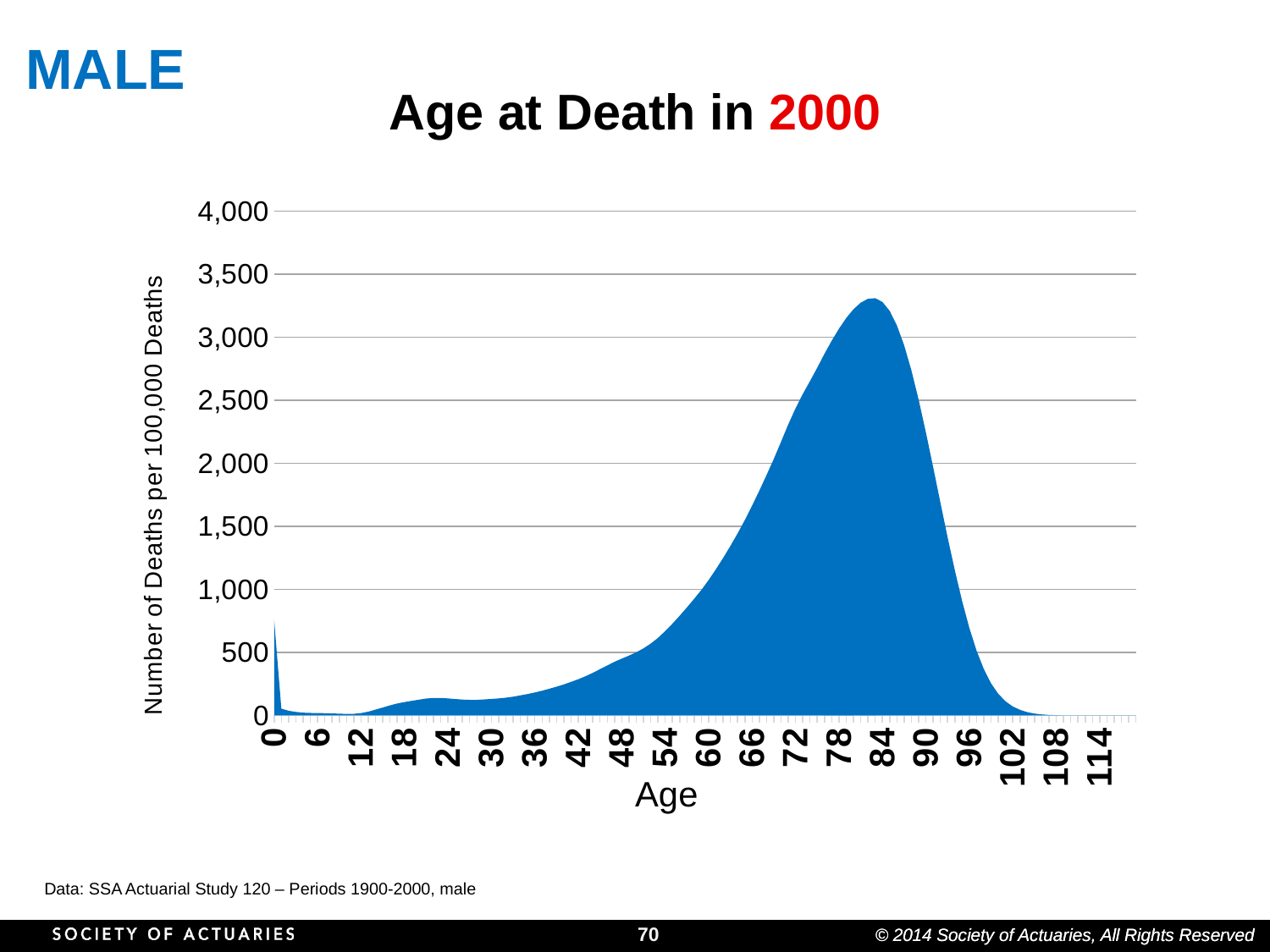
Is the peak value of the curve greater or less than 3,000? greater Do the values rise or fall as age increases from 54 to 78? rise Is the peak value of the curve greater or less than 3,500? less Do the values rise or fall as age increases from 84 to 102? fall Which is larger, the value at age 78 or the value at age 60? age 78 Is the value at age 102 greater or less than 500? less What is the title of the chart? Age at Death in 2000 What kind of chart is shown on the slide? area chart What is the label of the vertical axis? Number of Deaths per 100,000 Deaths